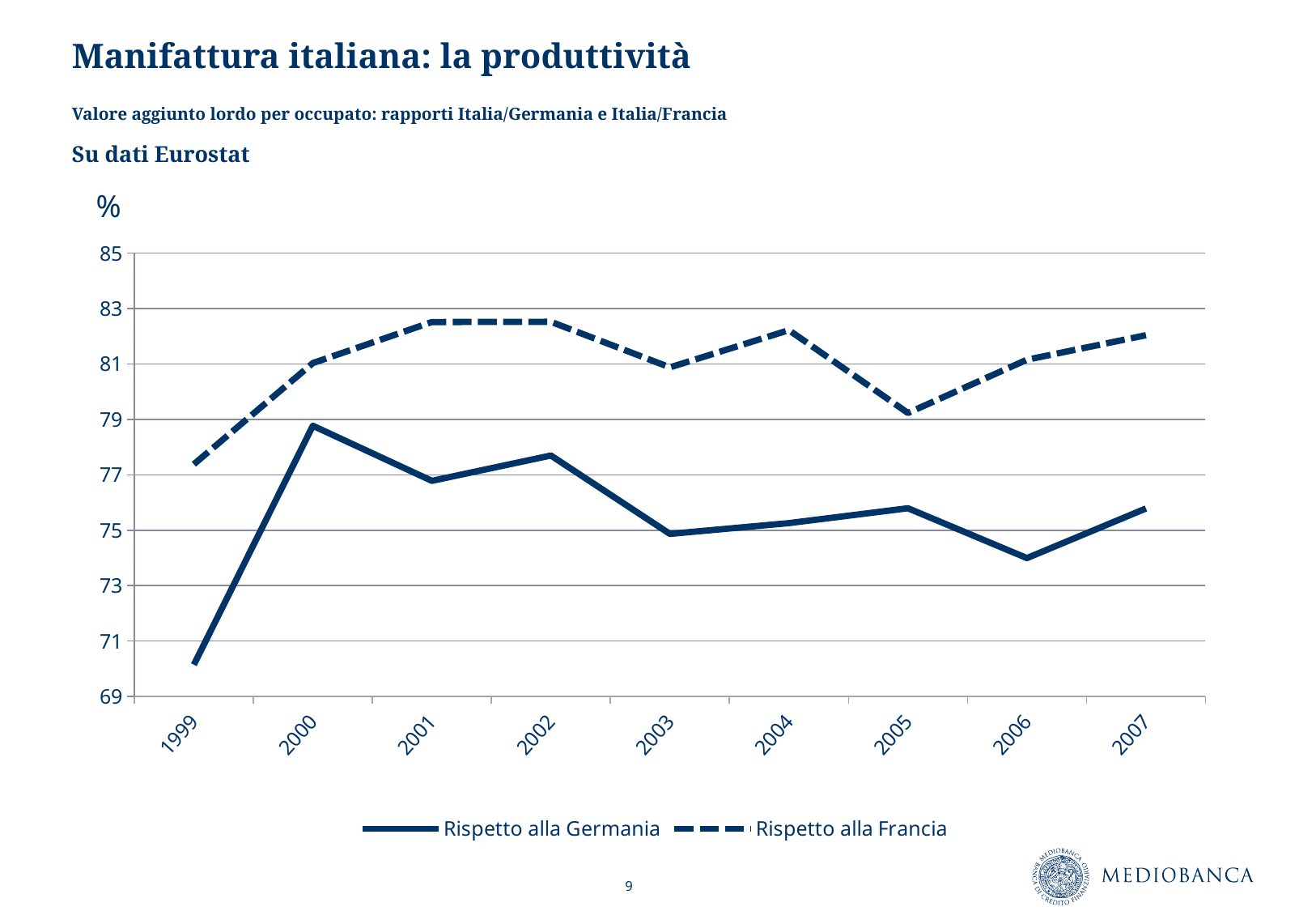
Which series is drawn with a dashed line? Rispetto alla Francia Is the value for 'Rispetto alla Francia' in 2001 greater or less than 81? greater How many series does the legend list? 2 Is the value for 'Rispetto alla Germania' in 1999 greater or less than 71? less What kind of chart is shown on the slide? line chart In 2004, which series has the larger value, 'Rispetto alla Germania' or 'Rispetto alla Francia'? Rispetto alla Francia How many years are plotted along the x axis? 9 Is the value for 'Rispetto alla Germania' in 2006 greater or less than 75? less Which year has the lowest value for the 'Rispetto alla Germania' series? 1999 Does the 'Rispetto alla Germania' series rise or fall from 1999 to 2000? rise Which year has the highest value for the 'Rispetto alla Germania' series? 2000 Which year has the lowest value for the 'Rispetto alla Francia' series? 1999